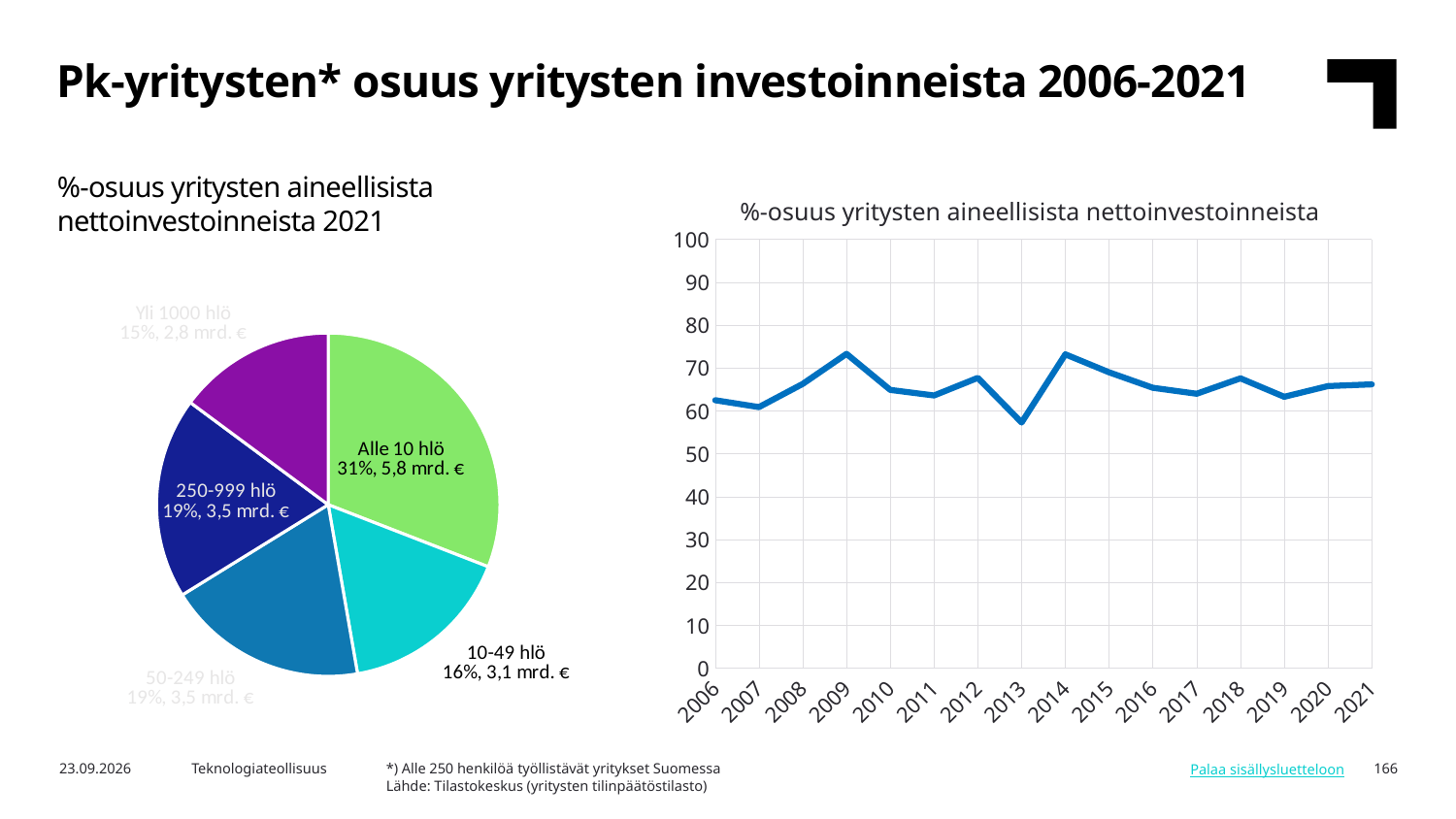
In the pie chart on the left, which category has the largest share? Alle 10 hlö What is the title of the line chart on the right? %-osuus yritysten aineellisista nettoinvestoinneista In the line chart on the right, is the value for 2013 greater or less than 60? less In the pie chart on the left, what is the difference in percentage points between 'Alle 10 hlö' and 'Yli 1000 hlö'? 16 In the pie chart on the left, what is the euro amount shown for '10-49 hlö'? 3,1 mrd. € In the pie chart on the left, which category has the smallest share? Yli 1000 hlö In the pie chart on the left, which has a larger share: '10-49 hlö' or '50-249 hlö'? 50-249 hlö How many slices does the pie chart on the left have? 5 In the line chart on the right, is the value for 2009 greater or less than 70? greater How many years are plotted on the x axis of the line chart on the right? 16 What type of chart is shown on the right side of the slide? Line chart In the pie chart on the left, what share of net investments is attributed to 'Alle 10 hlö'? 31%